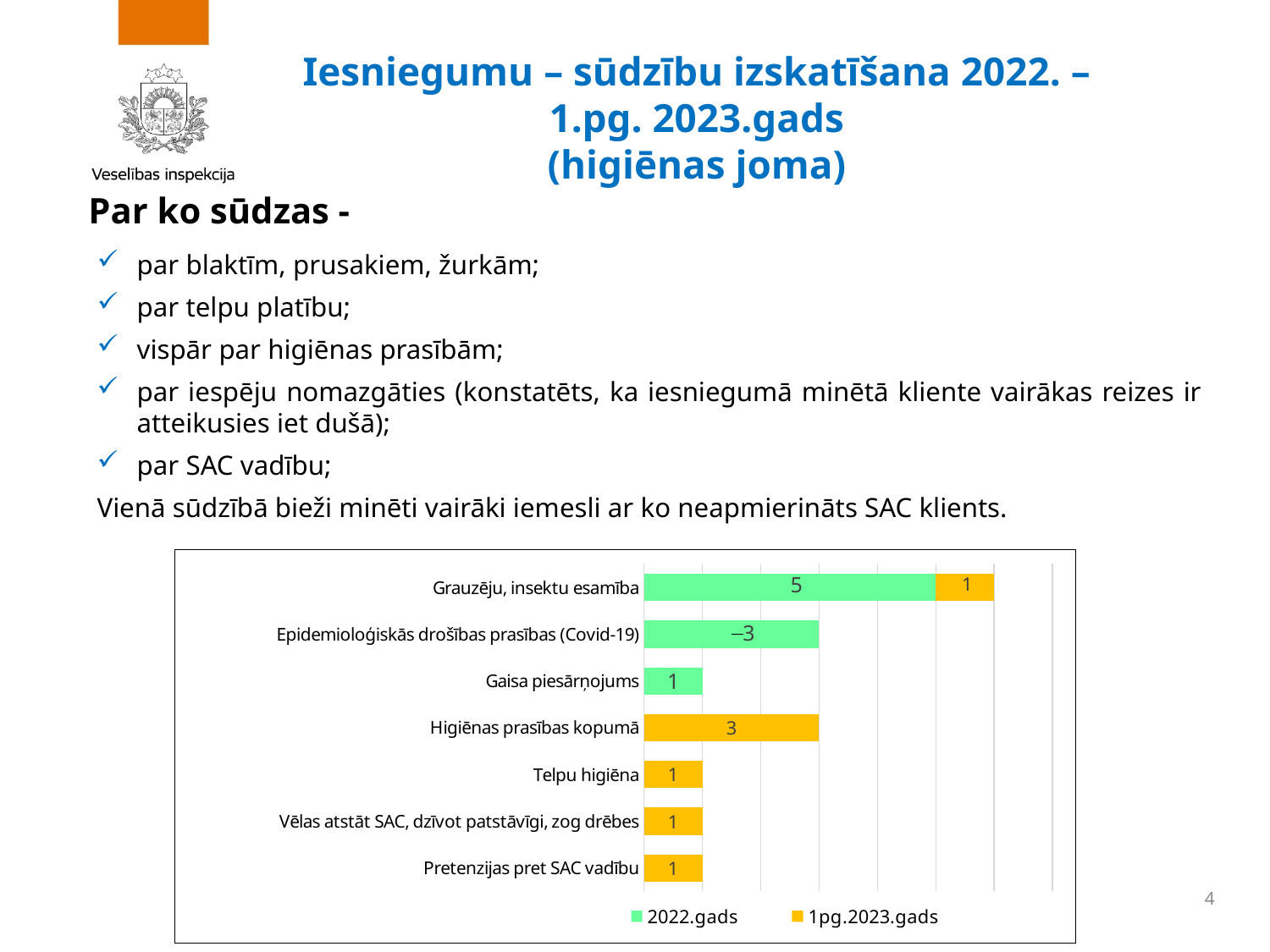
What is the 1pg.2023.gads value for Higiēnas prasības kopumā? 3 What is the 1pg.2023.gads value for Grauzēju, insektu esamība? 1 What kind of chart is shown on the slide? bar chart What is the total of the stacked bar for Grauzēju, insektu esamība? 6 How many series does the chart legend list? 2 Which series is shown in green in the chart? 2022.gads How many categories are shown in the chart? 7 What is the 2022.gads value for Gaisa piesārņojums? 1 Which category has the highest total value in the chart? Grauzēju, insektu esamība What is the 2022.gads value for Grauzēju, insektu esamība? 5 What is the 1pg.2023.gads value for Pretenzijas pret SAC vadību? 1 What is the difference between the 2022.gads value for Grauzēju, insektu esamība and the 2022.gads value for Gaisa piesārņojums? 4